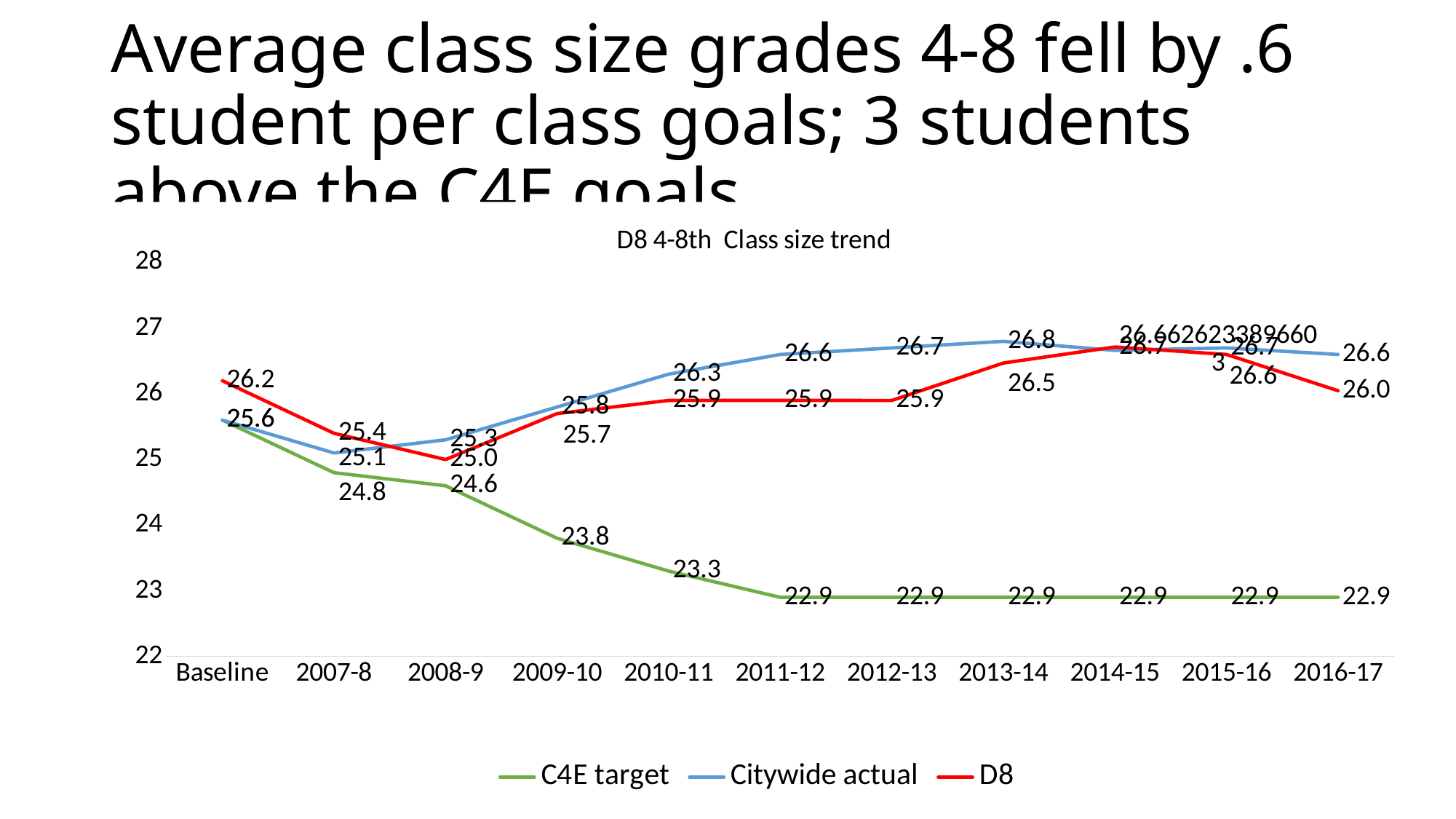
What is the difference between the D8 value and the C4E target value in 2016-17? 3.1 Does the C4E target series rise or fall from Baseline to 2016-17? fall What is the D8 value for 2016-17? 26.0 How many points are plotted along the x axis for each series? 11 What is the D8 value at Baseline? 26.2 What is the Citywide actual value for 2013-14? 26.8 What kind of chart is shown on the slide? line chart In 2016-17, which is larger: Citywide actual or D8? Citywide actual What colour is the D8 line? red In which year does the D8 series reach its lowest value? 2008-9 What is the C4E target value for 2010-11? 23.3 How many series does the legend list? 3